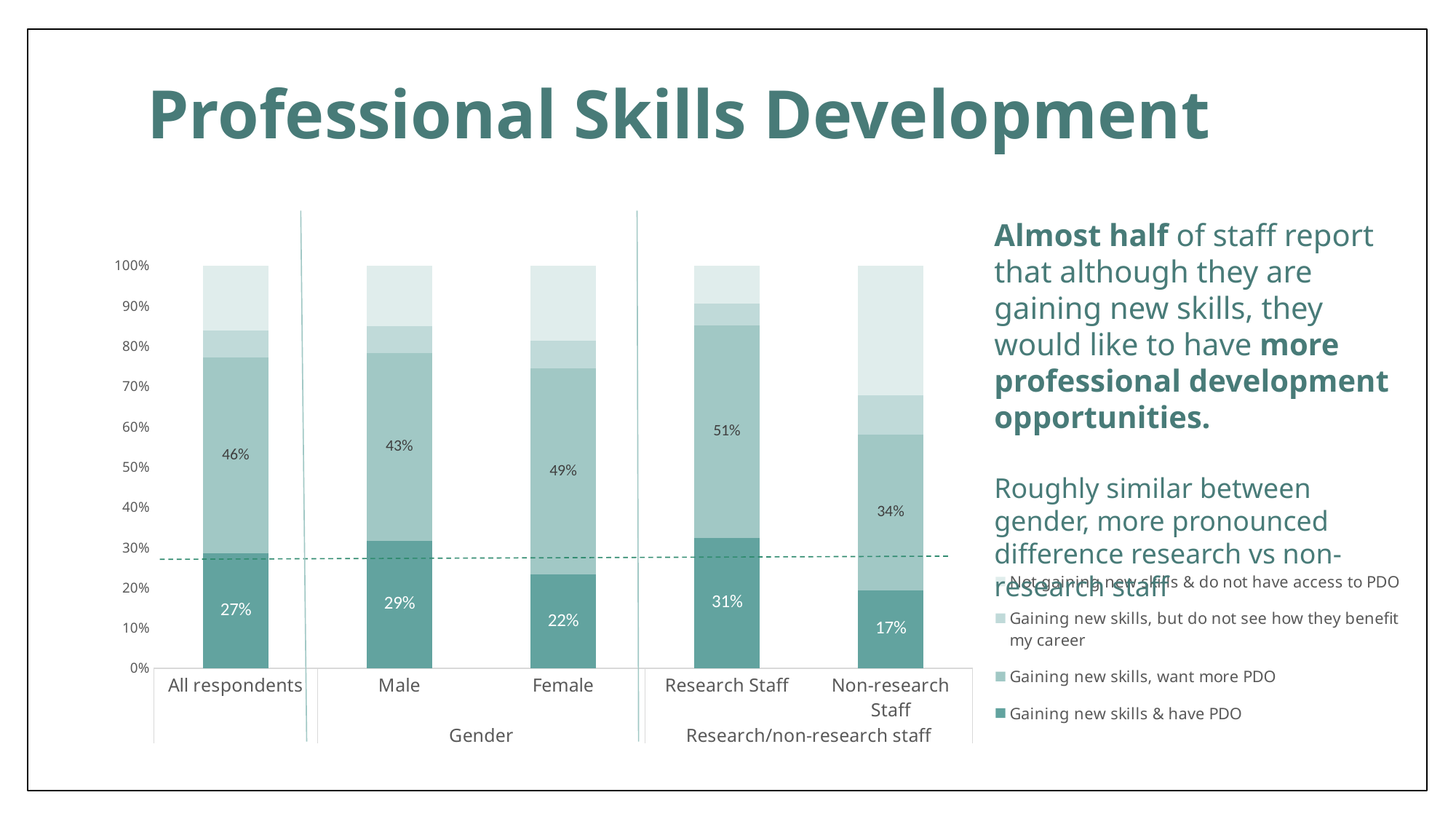
What percentage of Research Staff are in the 'Gaining new skills, want more PDO' group? 51% Which series is shown in the darkest colour in the chart? Gaining new skills & have PDO How many categories are shown along the x axis of the chart? 5 Which is larger, the 'Gaining new skills, want more PDO' value for Male or for Female? Female What kind of chart is shown on the slide? stacked bar chart How many series does the chart's legend list? 4 Which category has the lowest 'Gaining new skills, want more PDO' value? Non-research Staff What is the difference between the 'Gaining new skills & have PDO' values for Male and Female? 7% Is the 'Not gaining new skills & do not have access to PDO' segment for Non-research Staff greater or less than 20%? greater What percentage of Female respondents are in the 'Gaining new skills & have PDO' group? 22% What is the 'Gaining new skills & have PDO' value for All respondents? 27% Which category has the highest 'Gaining new skills & have PDO' value? Research Staff